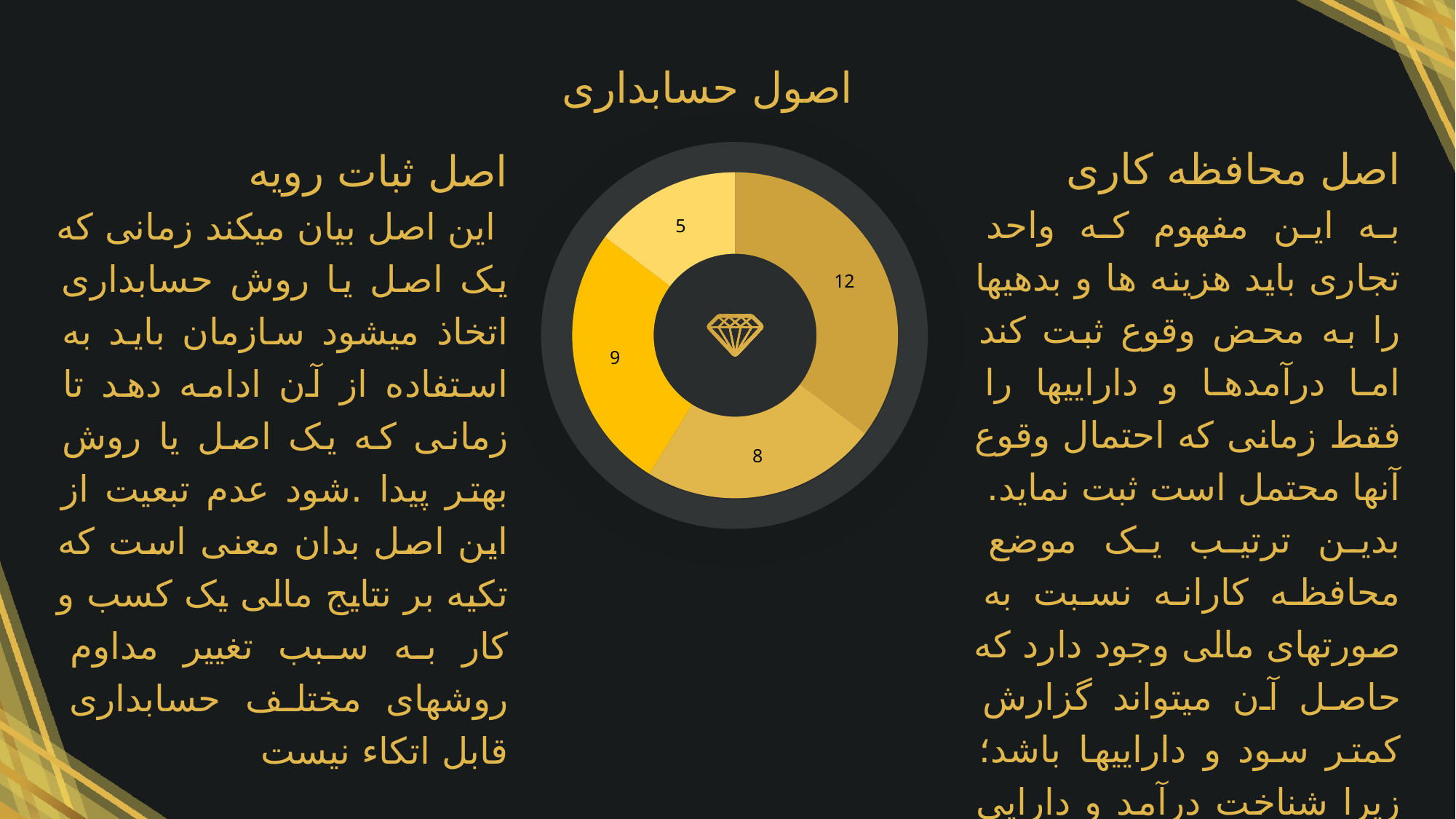
How many slices does the doughnut chart have? 4 What icon appears in the centre of the doughnut chart? A diamond What is the smallest value labelled on the doughnut chart? 5 What value is labelled on the lightest yellow slice of the doughnut chart? 5 What is the difference between the largest and smallest slice values on the doughnut chart? 7 What is the total of all four slice values on the doughnut chart? 34 What is the difference between the slices labelled 9 and 8 on the doughnut chart? 1 What is the largest value labelled on the doughnut chart? 12 Which slice is larger on the doughnut chart, the one labelled 9 or the one labelled 8? 9 What is the difference between the slices labelled 12 and 8 on the doughnut chart? 4 Which slice value on the doughnut chart is larger, 12 or 9? 12 What kind of chart is shown in the centre of the slide? Doughnut (pie) chart